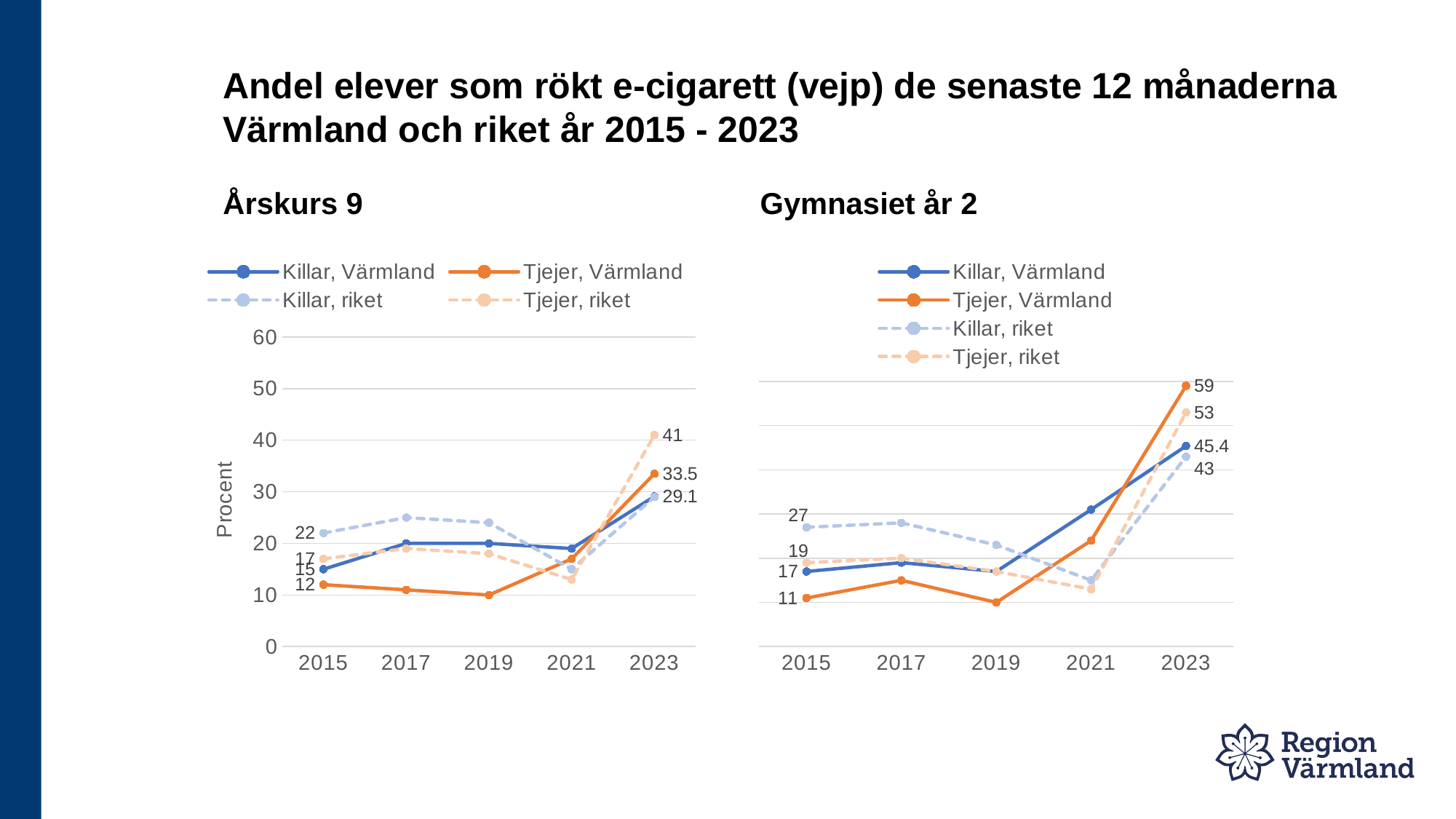
In the Årskurs 9 chart, what is the value for Killar, riket in 2015? 22 How many series does the legend of the Årskurs 9 chart list? 4 In the Årskurs 9 chart, what is the difference between Tjejer, riket and Tjejer, Värmland in 2023? 7.5 In the Årskurs 9 chart, what is the value for Tjejer, Värmland in 2023? 33.5 In the Gymnasiet år 2 chart, is the value for Killar, Värmland in 2021 greater or less than 20? greater In the Gymnasiet år 2 chart, which series has the highest value in 2023? Tjejer, Värmland In the Gymnasiet år 2 chart, what is the value for Tjejer, Värmland in 2015? 11 In the Gymnasiet år 2 chart, what is the value for Killar, Värmland in 2023? 45.4 What kind of chart is the Gymnasiet år 2 chart? Line chart In the Gymnasiet år 2 chart, what is the value for Tjejer, Värmland in 2023? 59 In the Gymnasiet år 2 chart, what is the difference between Tjejer, Värmland and Tjejer, riket in 2023? 6 In the Årskurs 9 chart, what is the value for Tjejer, riket in 2023? 41